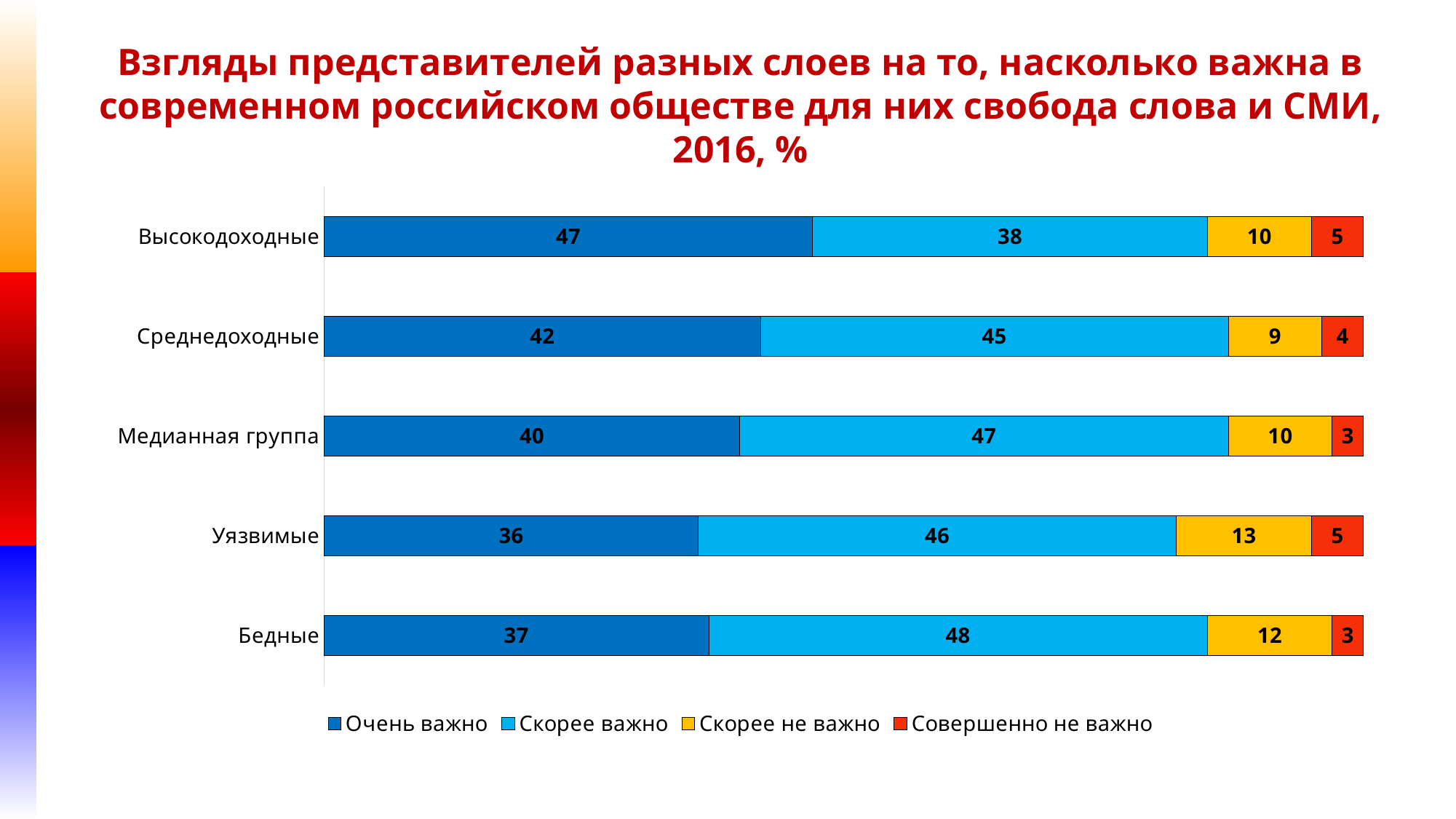
Which is larger: the "Очень важно" value for Среднедоходные or for Медианная группа? Среднедоходные How many series does the legend list? 4 What is the value of "Совершенно не важно" for Среднедоходные? 4 What kind of chart is shown on the slide? Stacked bar chart What is the value of "Очень важно" for Высокодоходные? 47 What is the value of "Скорее не важно" for Уязвимые? 13 What is the value of "Скорее важно" for Бедные? 48 Which category has the lowest value for "Очень важно"? Уязвимые What is the total of the stacked bar for Уязвимые? 100 How many categories are shown on the chart? 5 What is the difference between the "Скорее важно" values for Бедные and Высокодоходные? 10 Which category has the highest value for "Очень важно"? Высокодоходные